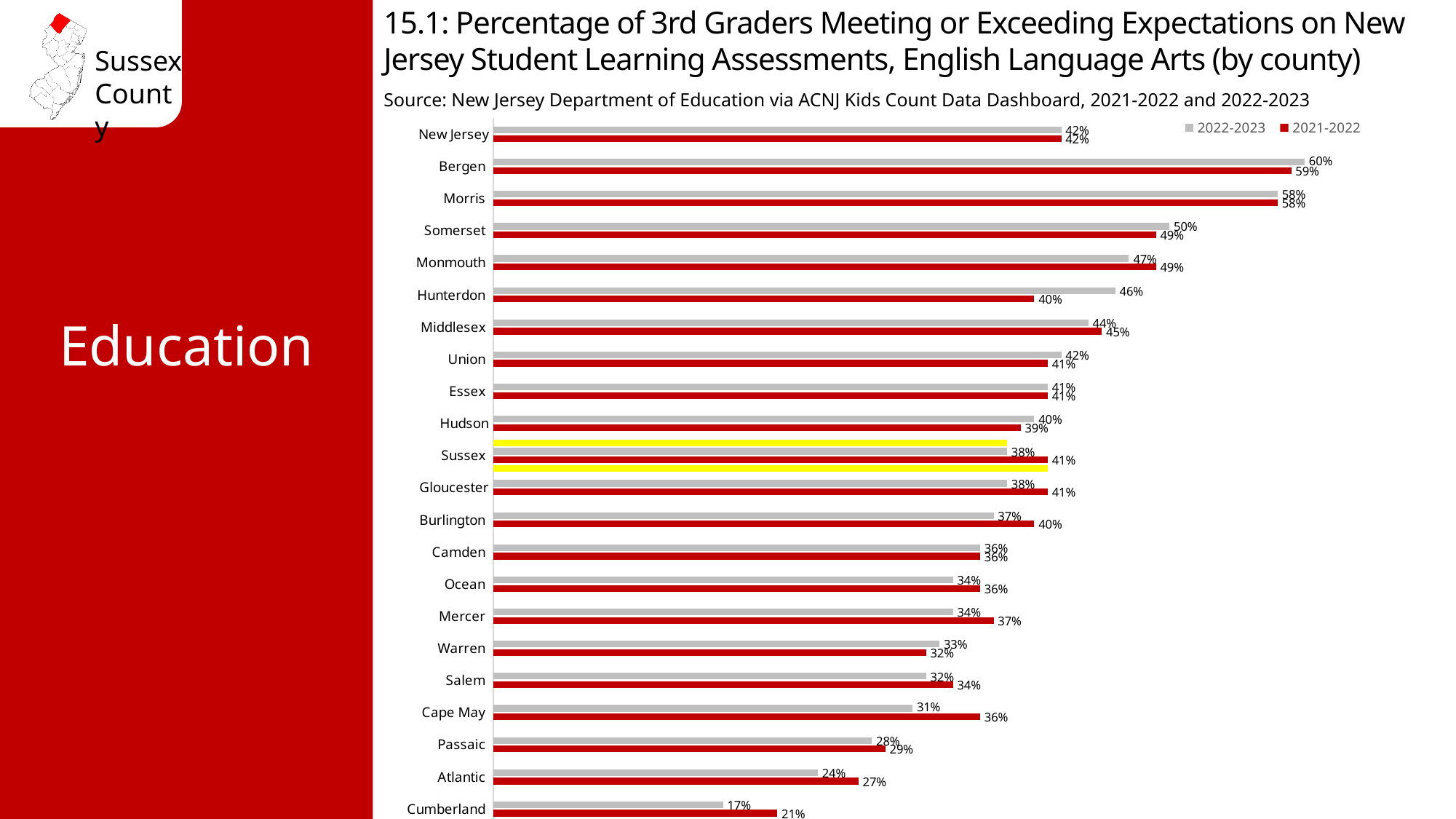
What is the 2022-2023 value for Bergen? 60% How many series does the legend list? 2 Which county has the lowest 2022-2023 value? Cumberland What is the 2021-2022 value for Cumberland? 21% What is the 2022-2023 value for New Jersey? 42% What is the difference between the 2022-2023 values for Bergen and Cumberland? 43% What is the 2022-2023 value for Sussex? 38% What is the 2021-2022 value for Sussex? 41% Which county's bars are highlighted in yellow? Sussex Which county has the highest 2022-2023 value? Bergen Which is larger for Hunterdon: the 2022-2023 value or the 2021-2022 value? 2022-2023 What kind of chart is shown? Bar chart